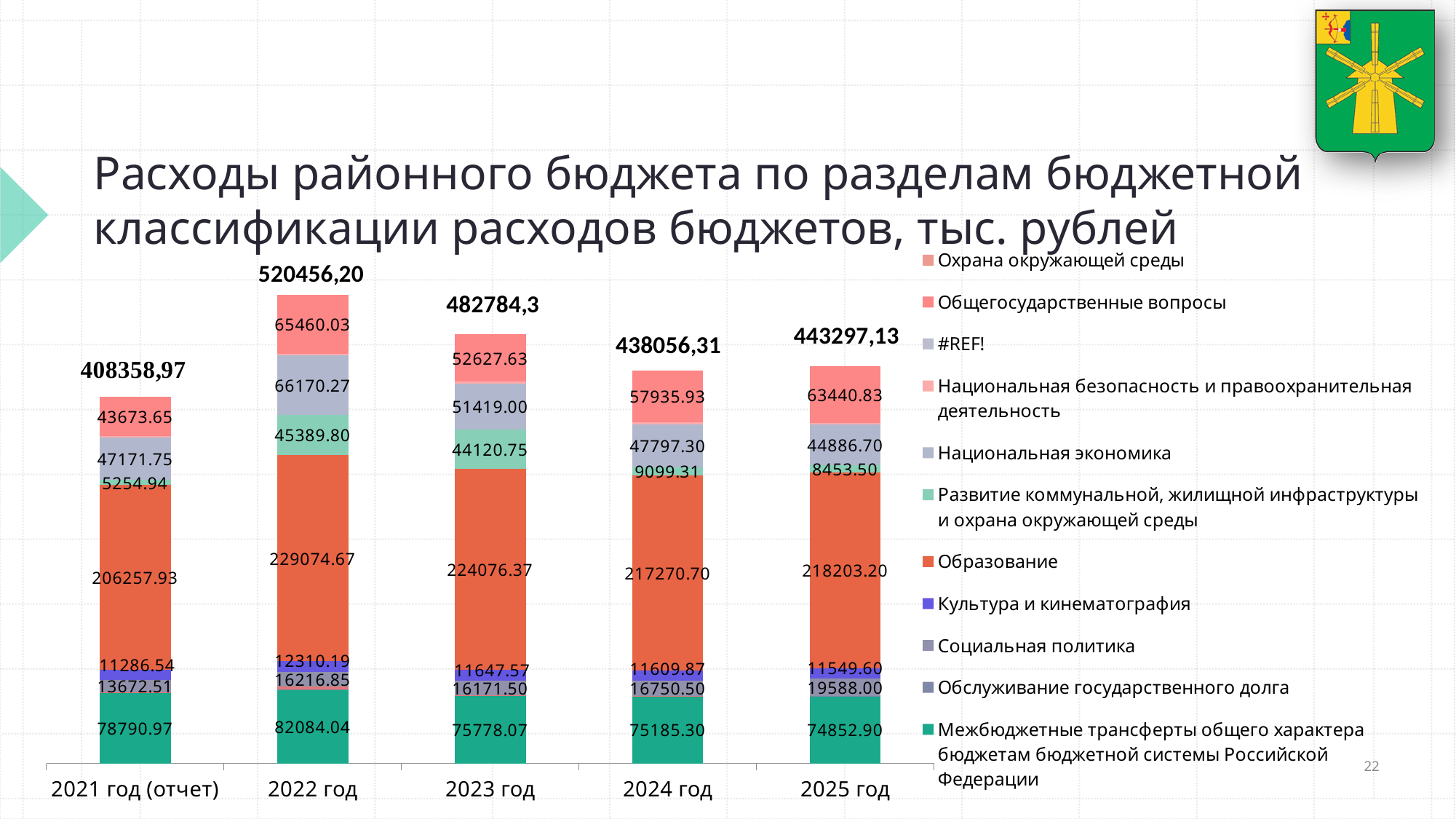
How many entries does the chart's legend list? 11 Which year has the larger value for Образование, 2023 год or 2024 год? 2023 год By how much does the value for Образование in 2022 год exceed the value in 2021 год (отчет)? 22816.74 Which year has the lowest total expenditure? 2021 год (отчет) What is the value for Межбюджетные трансферты общего характера бюджетам бюджетной системы Российской Федерации in 2021 год (отчет)? 78790.97 What is the value for Образование in 2022 год? 229074.67 Do the total expenditures rise or fall from 2022 год to 2024 год? Fall What is the value for Культура и кинематография in 2025 год? 11549.60 What kind of chart is shown on the slide? Stacked bar chart What is the total of the stacked bar for 2023 год? 482784,3 How many years (categories) are shown on the x axis of the chart? 5 Which year has the highest total expenditure? 2022 год